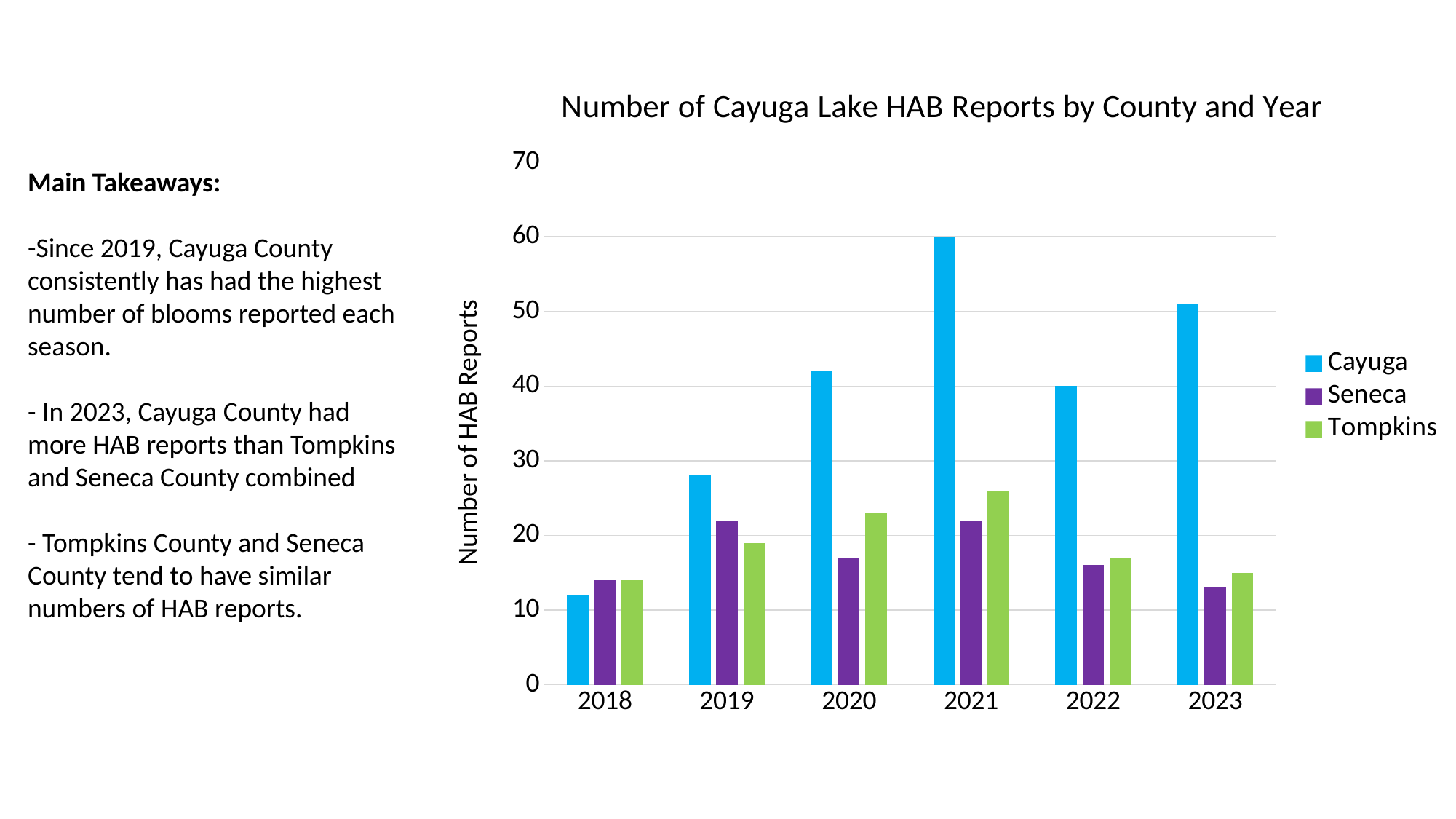
What is the title of the chart? Number of Cayuga Lake HAB Reports by County and Year What is the number of HAB reports for Cayuga in 2021? 60 What kind of chart is shown on the slide? Bar chart In which year is the Cayuga bar the highest? 2021 Which colour represents Tompkins in the legend? Green How many series does the legend list? 3 In which year is the Cayuga bar the lowest? 2018 What is the number of HAB reports for Cayuga in 2022? 40 Is the value for Seneca in 2020 greater or less than 20? less How many years are shown on the x axis? 6 In 2021, which is larger, the Seneca bar or the Tompkins bar? Tompkins Is the value for Tompkins in 2021 greater or less than 20? greater